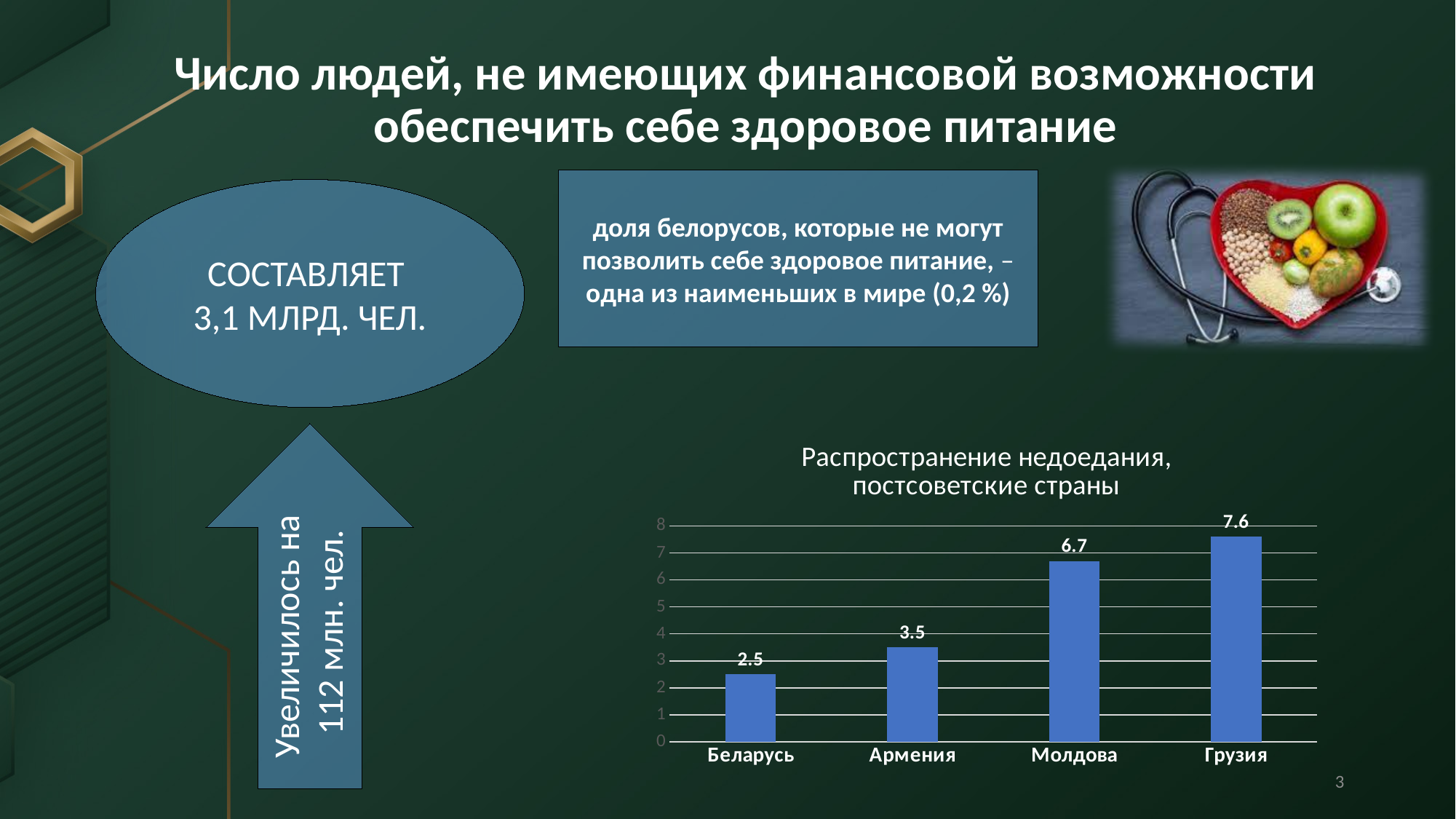
Which country has the lowest value in the chart? Беларусь What type of chart is shown on the slide? Bar chart How many countries are shown in the chart? 4 Which has a larger value, Армения or Молдова? Молдова What is the difference between the values for Грузия and Беларусь? 5.1 What is the value for Армения in the chart? 3.5 What is the difference between the values for Молдова and Армения? 3.2 What is the value for Грузия in the chart? 7.6 What is the value for Молдова in the chart? 6.7 What is the title of the chart? Распространение недоедания, постсоветские страны What is the value for Беларусь in the chart? 2.5 Which country has the highest value in the chart? Грузия